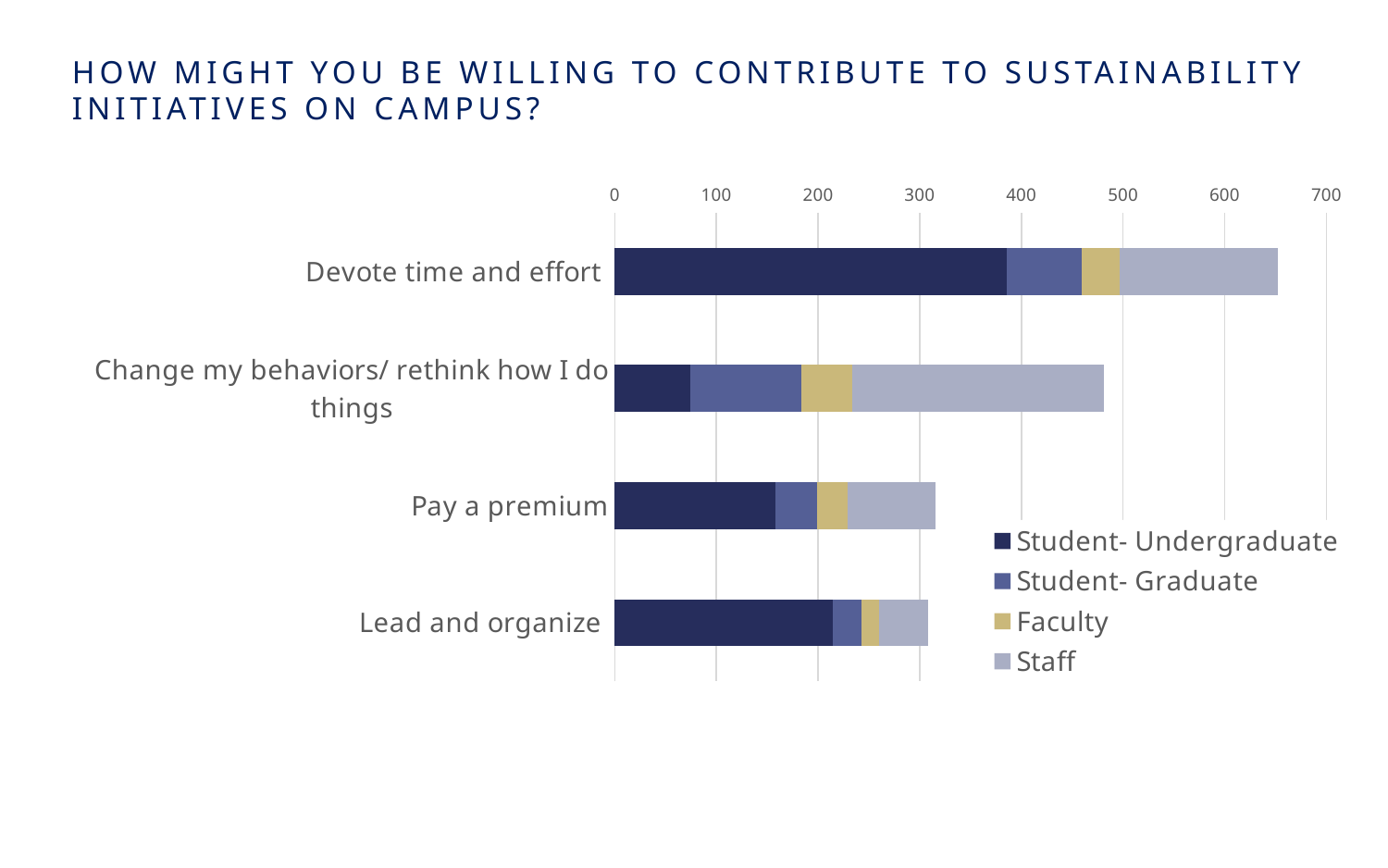
Is the total value for Devote time and effort greater or less than 600? greater How many categories are shown on the chart? 4 Is the total value for Lead and organize greater or less than 400? less Is the Student- Undergraduate value for Devote time and effort greater or less than 300? greater What kind of chart is shown on the slide? stacked bar chart Which category has the longest total bar? Devote time and effort Which has a longer total bar: Devote time and effort or Change my behaviors/ rethink how I do things? Devote time and effort What is the title of the chart? How might you be willing to contribute to sustainability initiatives on campus? Which series is listed last in the legend? Staff How many series does the legend list? 4